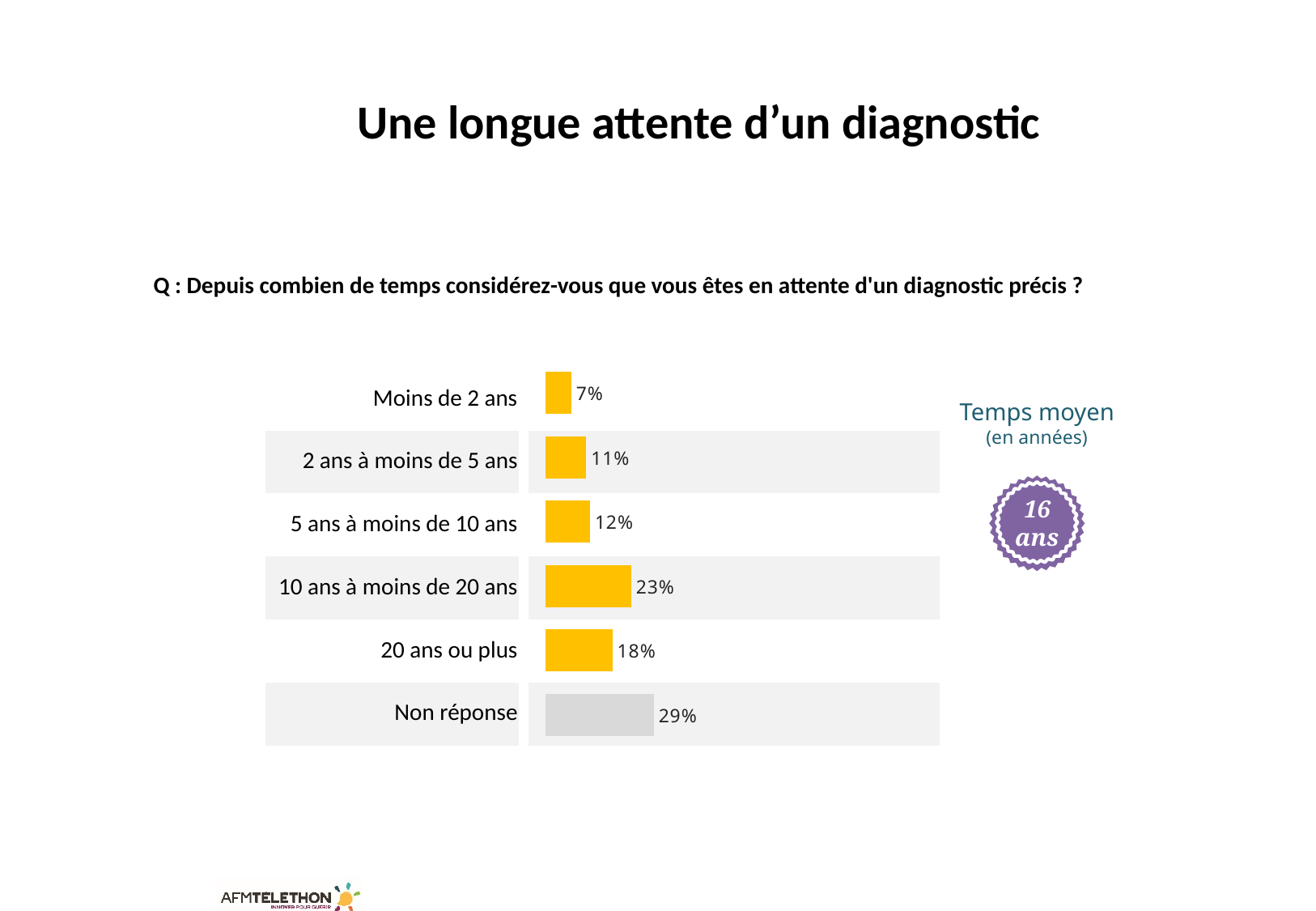
Which category has the lowest value? Moins de 2 ans What kind of chart is shown on the slide? Bar chart How many categories are shown in the chart? 6 What is the value for "20 ans ou plus"? 18% What is the value for "Non réponse"? 29% What is the value for "Moins de 2 ans"? 7% Which is larger, the value for "2 ans à moins de 5 ans" or the value for "5 ans à moins de 10 ans"? 5 ans à moins de 10 ans Which category has the highest value? Non réponse Which bar is coloured grey instead of yellow? Non réponse What is the value for "10 ans à moins de 20 ans"? 23% What is the average waiting time ("Temps moyen") shown next to the chart? 16 ans What is the difference between the values for "10 ans à moins de 20 ans" and "20 ans ou plus"? 5%